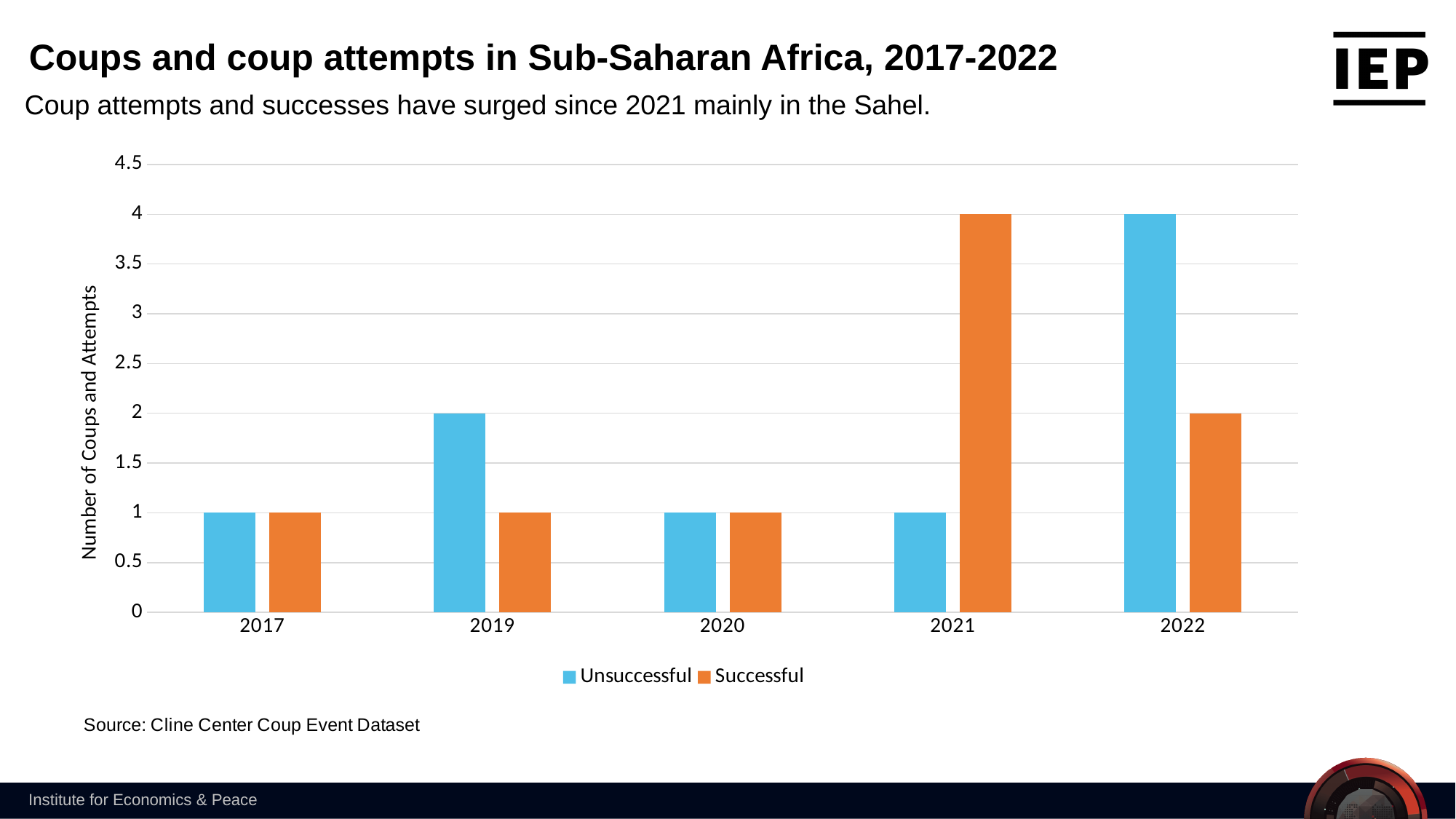
What is the number of unsuccessful coup attempts in 2019? 2 What is the difference between unsuccessful and successful coups in 2022? 2 In which year is the Unsuccessful series highest? 2022 What is the total number of coups and attempts (successful plus unsuccessful) in 2021? 5 How many series does the legend list? 2 What type of chart is shown on the slide? bar chart What is the number of successful coups in 2021? 4 In which year is the Successful series highest? 2021 Which colour represents the Successful series in the legend? orange How many years are shown on the x axis? 5 In 2021, which is larger: the number of successful or unsuccessful coups? Successful What is the number of unsuccessful coup attempts in 2022? 4